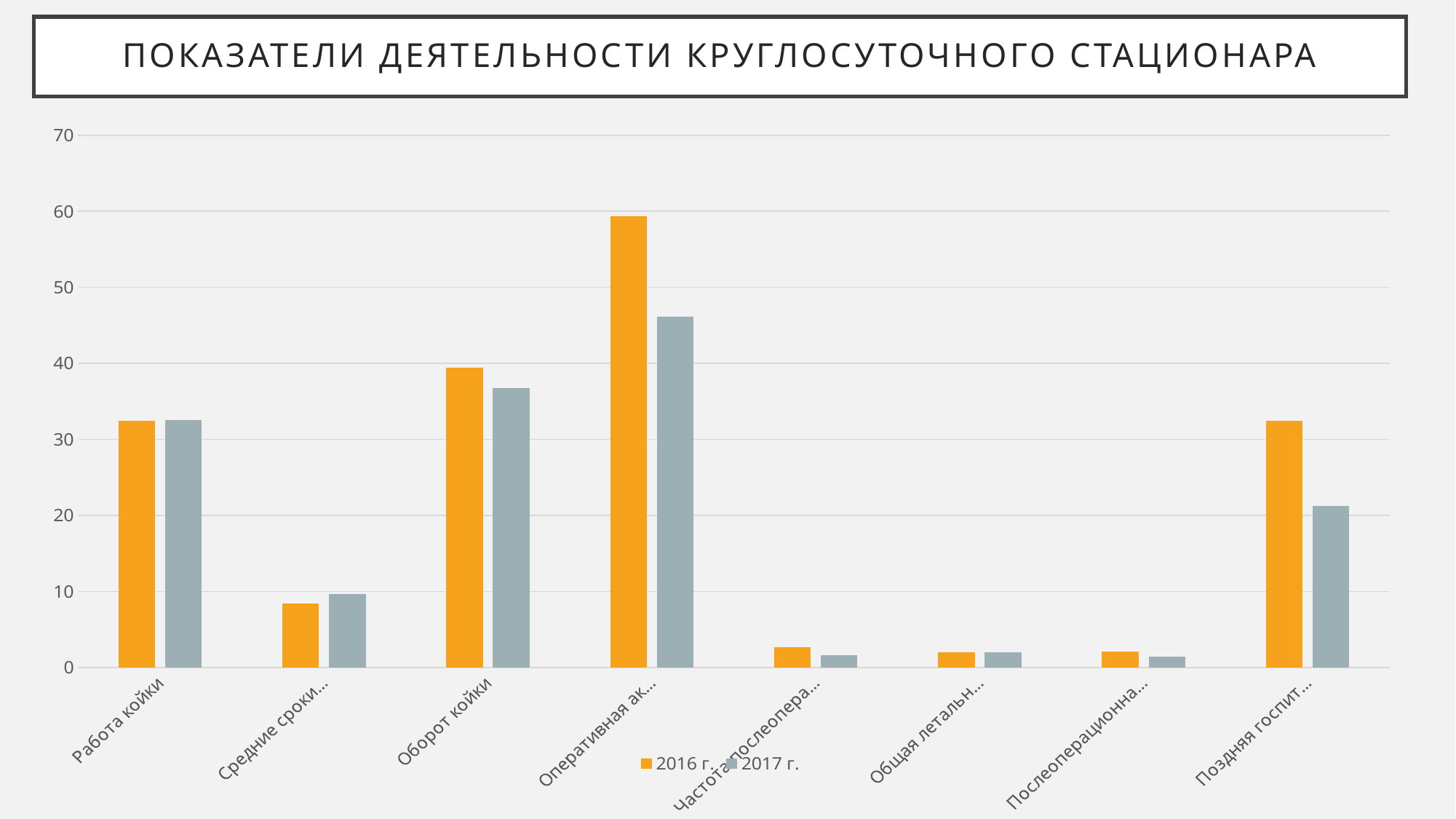
How many series does the legend list? 2 Which category has the highest value for 2016 г.? Оперативная ак... What kind of chart is shown on the slide? bar chart Which category has the highest value for 2017 г.? Оперативная ак... What is the title of the chart? ПОКАЗАТЕЛИ ДЕЯТЕЛЬНОСТИ КРУГЛОСУТОЧНОГО СТАЦИОНАРА How many categories are shown on the x axis? 8 Is the 2016 г. value for Работа койки greater or less than 30? greater Which series is shown in orange? 2016 г. For Средние сроки..., which series has the larger value, 2016 г. or 2017 г.? 2017 г. Is the 2016 г. value for Оперативная ак... greater or less than 50? greater For Поздняя госпит..., which series has the larger value, 2016 г. or 2017 г.? 2016 г. Is the 2017 г. value for Поздняя госпит... greater or less than 30? less